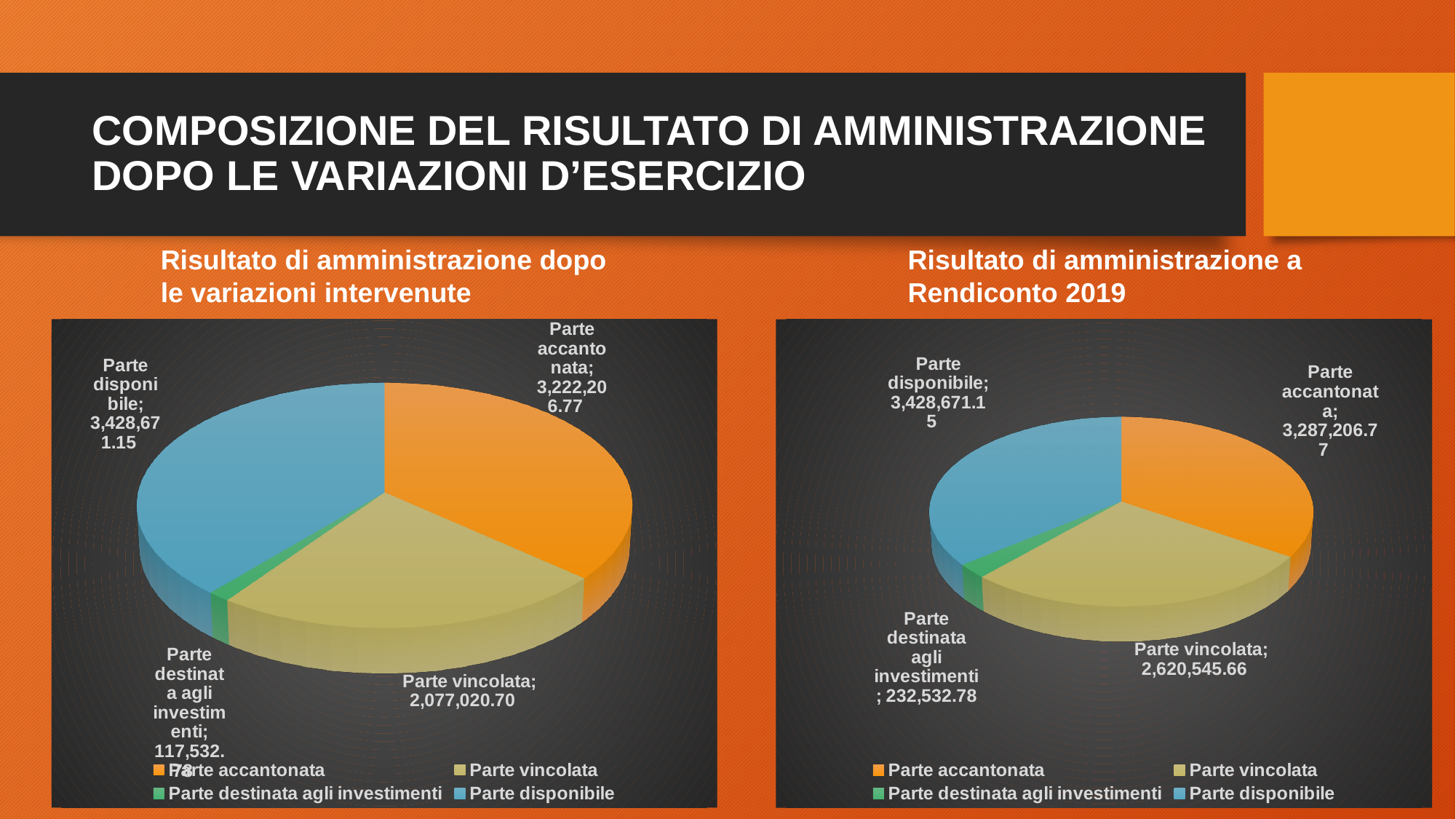
In the right chart (Risultato di amministrazione a Rendiconto 2019), which is larger: Parte vincolata or Parte destinata agli investimenti? Parte vincolata In the right chart (Risultato di amministrazione a Rendiconto 2019), what is the value for Parte accantonata? 3,287,206.77 What type of chart is used for the left chart (Risultato di amministrazione dopo le variazioni intervenute)? Pie chart In the left chart (Risultato di amministrazione dopo le variazioni intervenute), what is the value for Parte vincolata? 2,077,020.70 In the right chart (Risultato di amministrazione a Rendiconto 2019), what is the value for Parte destinata agli investimenti? 232,532.78 In the right chart (Risultato di amministrazione a Rendiconto 2019), what is the value for Parte vincolata? 2,620,545.66 In the left chart (Risultato di amministrazione dopo le variazioni intervenute), what is the difference between Parte accantonata and Parte vincolata? 1,145,186.07 In the left chart (Risultato di amministrazione dopo le variazioni intervenute), what is the value for Parte accantonata? 3,222,206.77 In the left chart (Risultato di amministrazione dopo le variazioni intervenute), which category has the smallest slice? Parte destinata agli investimenti In the left chart (Risultato di amministrazione dopo le variazioni intervenute), which category has the largest value? Parte disponibile In the right chart (Risultato di amministrazione a Rendiconto 2019), which category has the largest value? Parte disponibile In the right chart (Risultato di amministrazione a Rendiconto 2019), what is the difference between Parte disponibile and Parte accantonata? 141,464.38